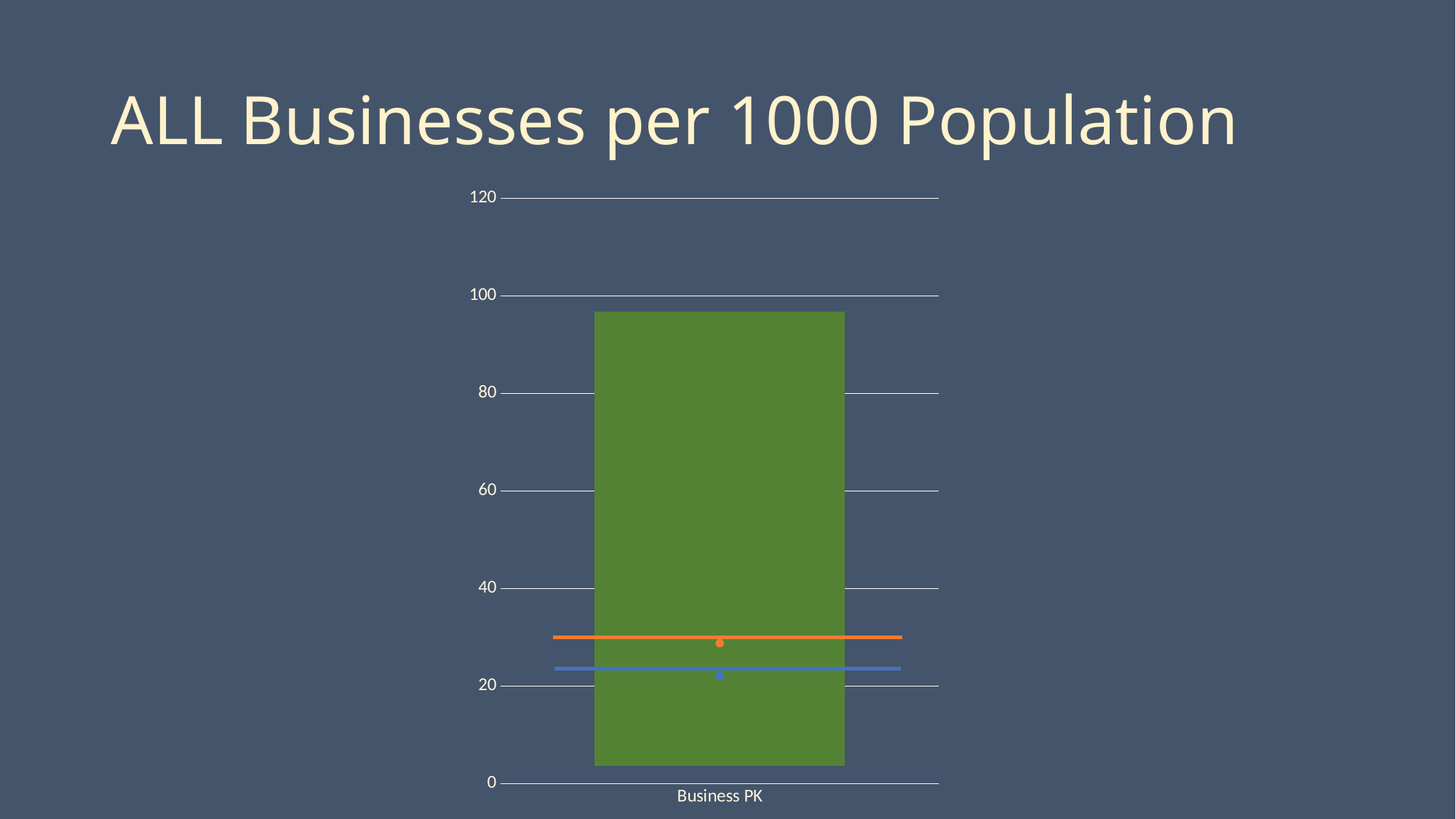
What is the label of the single category on the x axis? Business PK Is the orange horizontal line greater or less than 40? less What kind of chart is shown on the slide? bar chart Is the top of the green bar for Business PK greater or less than 80? greater How many categories are shown on the x axis of the chart? 1 Is the orange horizontal line greater or less than 20? greater Which is higher on the chart, the orange horizontal line or the blue horizontal line? the orange line Which reaches a higher value, the green bar or the orange horizontal line? the green bar What is the title of the chart on the slide? ALL Businesses per 1000 Population What is the highest value shown on the vertical axis? 120